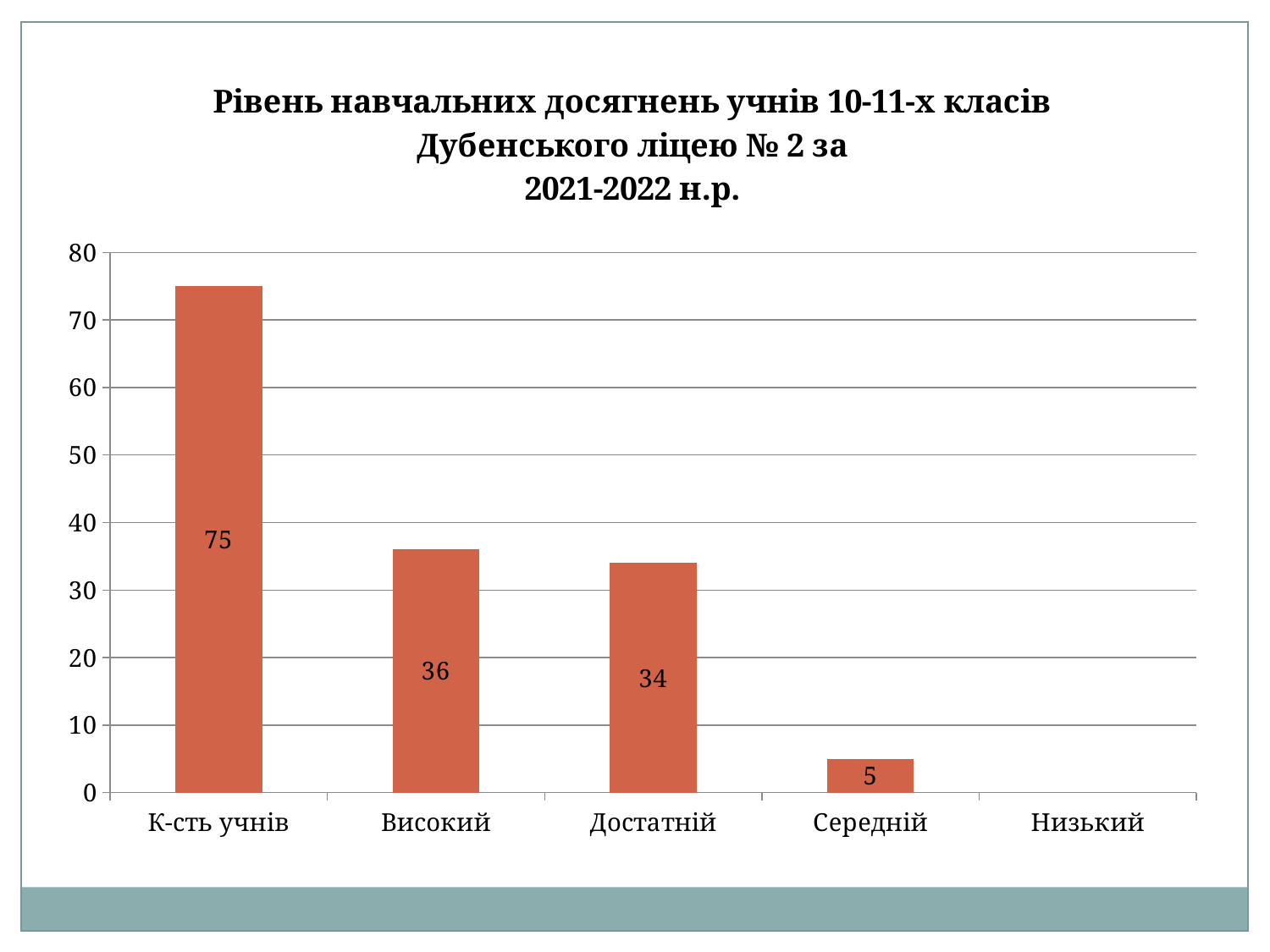
Which category has the highest value? К-сть учнів Which is larger, the value for Високий or the value for Середній? Високий What is the highest value shown on the vertical axis? 80 What is the value for Середній? 5 What is the value for Високий? 36 What is the value for Достатній? 34 What is the value for К-сть учнів? 75 What is the difference between the values for К-сть учнів and Середній? 70 How many categories are shown on the x axis? 5 What kind of chart is shown on the slide? bar chart Which category with a visible bar has the lowest value? Середній What is the difference between the values for Високий and Достатній? 2